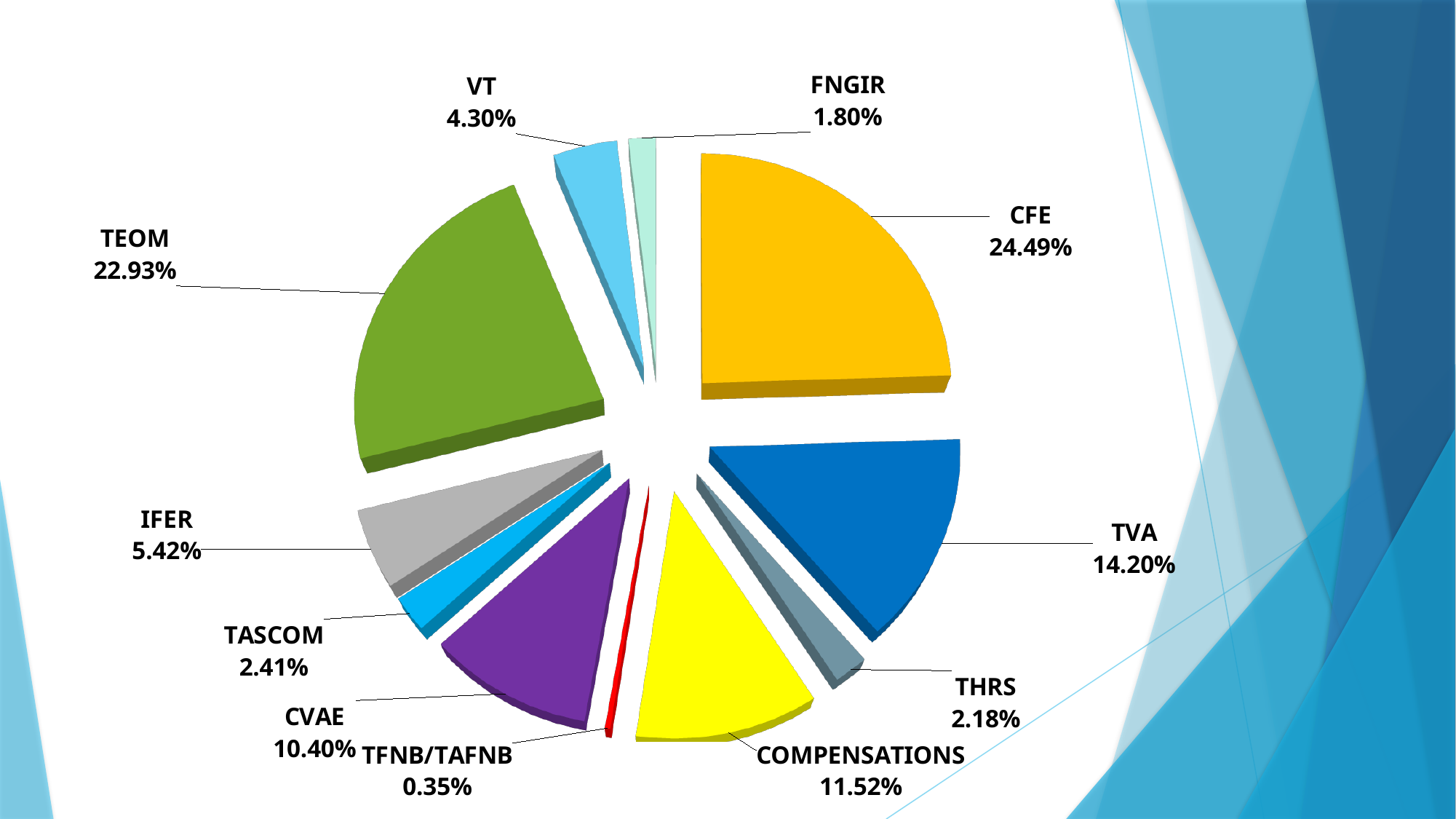
What is the value shown for TFNB/TAFNB? 0.35% Which is larger, the share for COMPENSATIONS or the share for CVAE? COMPENSATIONS What colour is the slice for CVAE? Purple How many categories are shown in the pie chart? 11 What is the value shown for TVA? 14.20% What is the difference between the IFER and TASCOM shares? 3.01% What is the value shown for TEOM? 22.93% Which category has the largest slice of the pie? CFE What share of the pie does CFE represent? 24.49% What is the difference between the CFE and TEOM shares? 1.56% What kind of chart is shown on the slide? Pie chart Which category has the smallest slice of the pie? TFNB/TAFNB